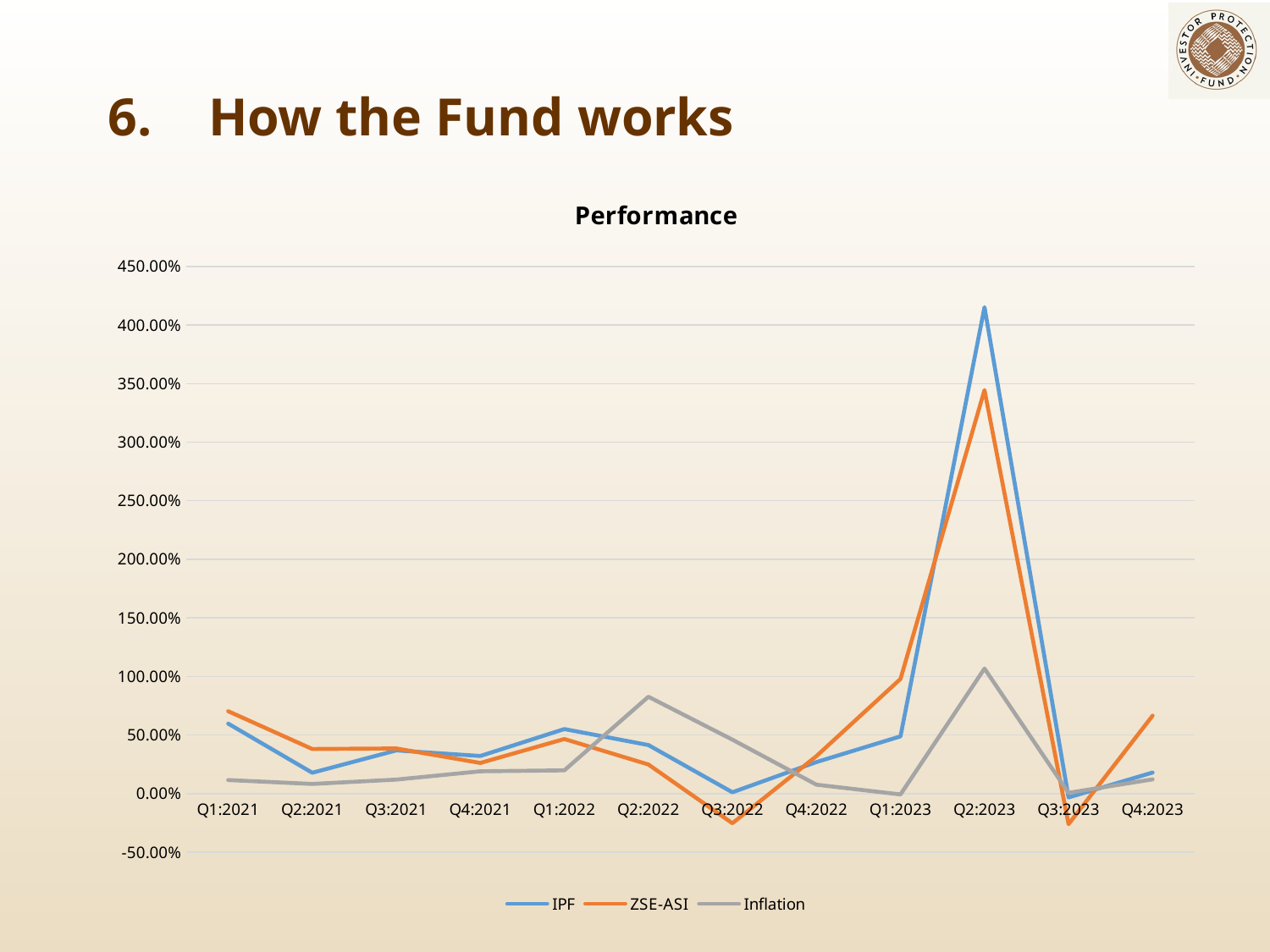
How many quarters are plotted along the x axis? 12 Is the IPF value for Q2:2023 greater or less than 400.00%? greater Which series are listed in the legend? IPF, ZSE-ASI, Inflation In which quarter does the IPF series reach its highest value? Q2:2023 Does the IPF series rise or fall from Q2:2023 to Q3:2023? Fall Is the ZSE-ASI value for Q2:2023 greater or less than 300.00%? greater Is the Inflation value for Q2:2022 greater or less than 50.00%? greater How many series does the legend list? 3 What kind of chart is shown on the slide? Line chart At Q2:2023, which is larger, IPF or ZSE-ASI? IPF What is the title of the chart? Performance